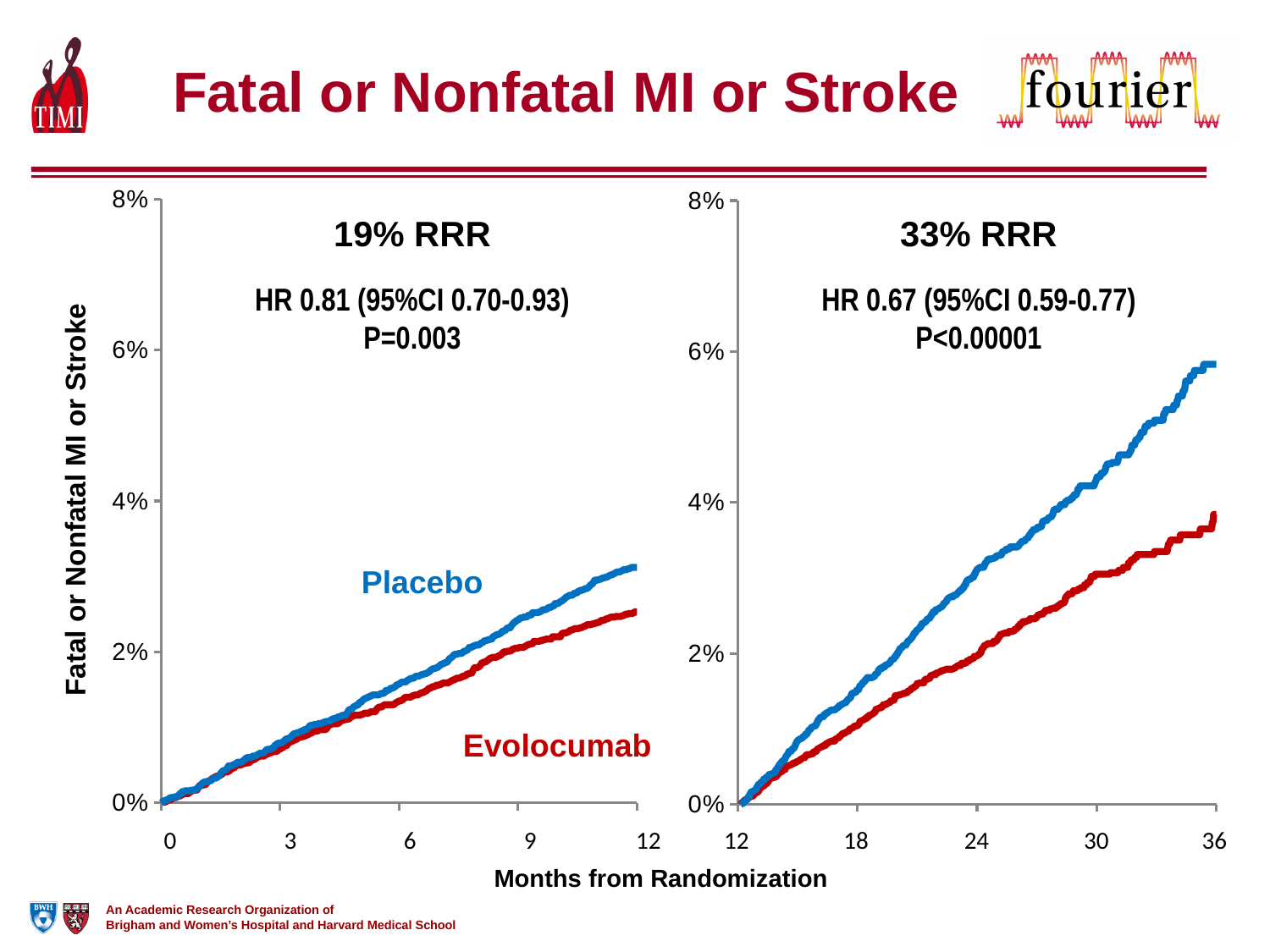
What relative risk reduction (RRR) is stated on the right chart (months 12 to 36)? 33% RRR On the left chart (months 0 to 12), does the Placebo curve rise or fall as months increase? rise What kind of chart is the right chart (months 12 to 36)? line chart How many series are plotted on the left chart (months 0 to 12)? 2 On the right chart (months 12 to 36), does the Evolocumab curve rise or fall as months increase? rise On the left chart (months 0 to 12), which series is higher at month 12, Placebo or Evolocumab? Placebo What kind of chart is the left chart (months 0 to 12)? line chart On the right chart (months 12 to 36), is the value for Evolocumab at month 36 greater or less than 4%? less On the right chart (months 12 to 36), which series is lower at month 36, Placebo or Evolocumab? Evolocumab On the right chart (months 12 to 36), is the value for Placebo at month 36 greater or less than 4%? greater On the left chart (months 0 to 12), is the value for Placebo at month 12 greater or less than 2%? greater What hazard ratio is stated on the left chart (months 0 to 12)? HR 0.81 (95%CI 0.70-0.93)